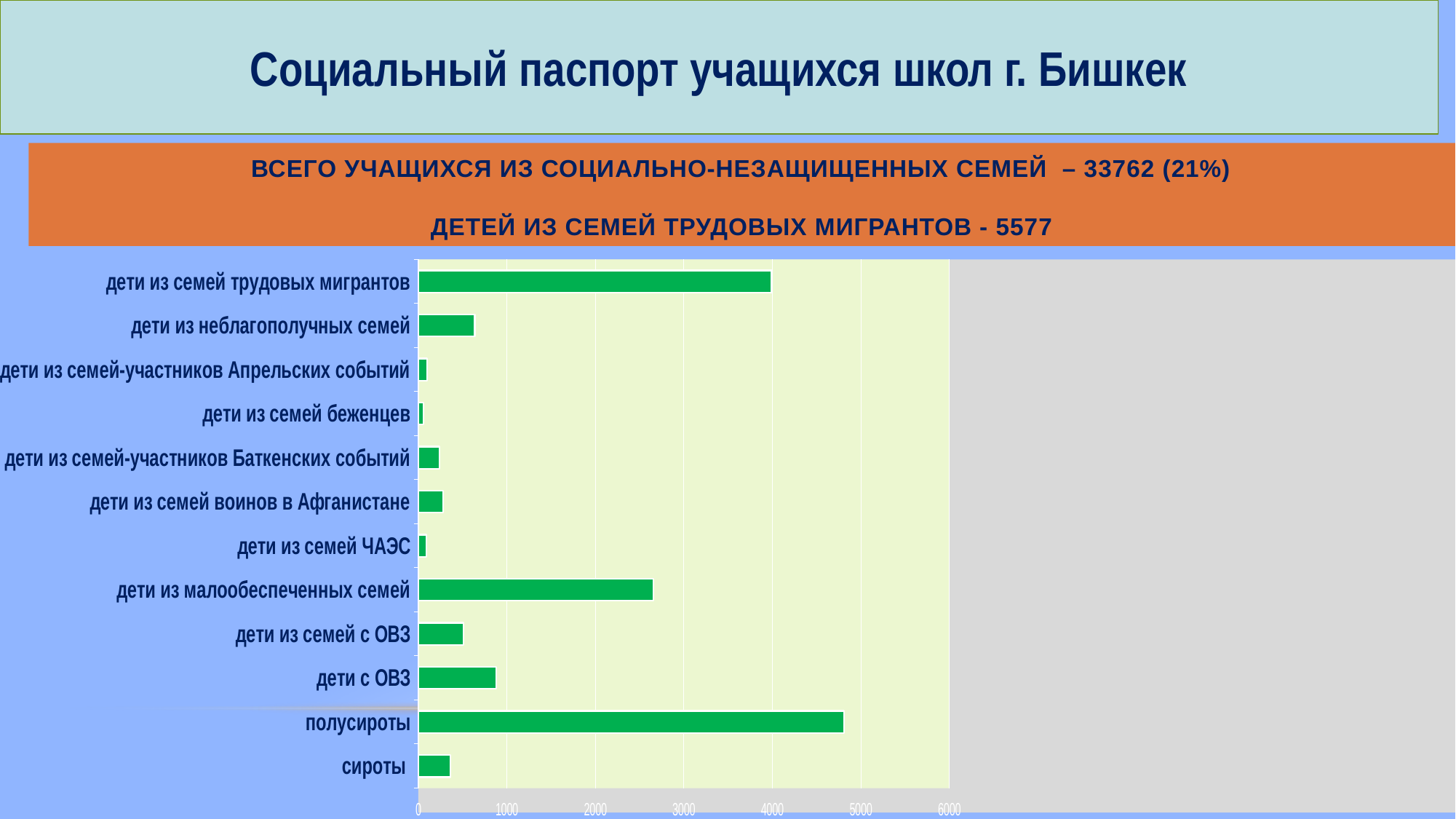
What colour are the bars in the chart? green Which category has the highest value in the chart? полусироты Is the value for полусироты greater or less than 4000? greater Is the value for дети из неблагополучных семей greater or less than 1000? less Which is larger: the value for дети с ОВЗ or for дети из семей с ОВЗ? дети с ОВЗ Which is larger: the value for дети из семей трудовых мигрантов or for дети из малообеспеченных семей? дети из семей трудовых мигрантов How many categories are plotted in the chart? 12 What kind of chart is shown on the slide? bar chart Which category has the lowest value in the chart? дети из семей беженцев Is the value for дети из семей трудовых мигрантов greater or less than 3000? greater